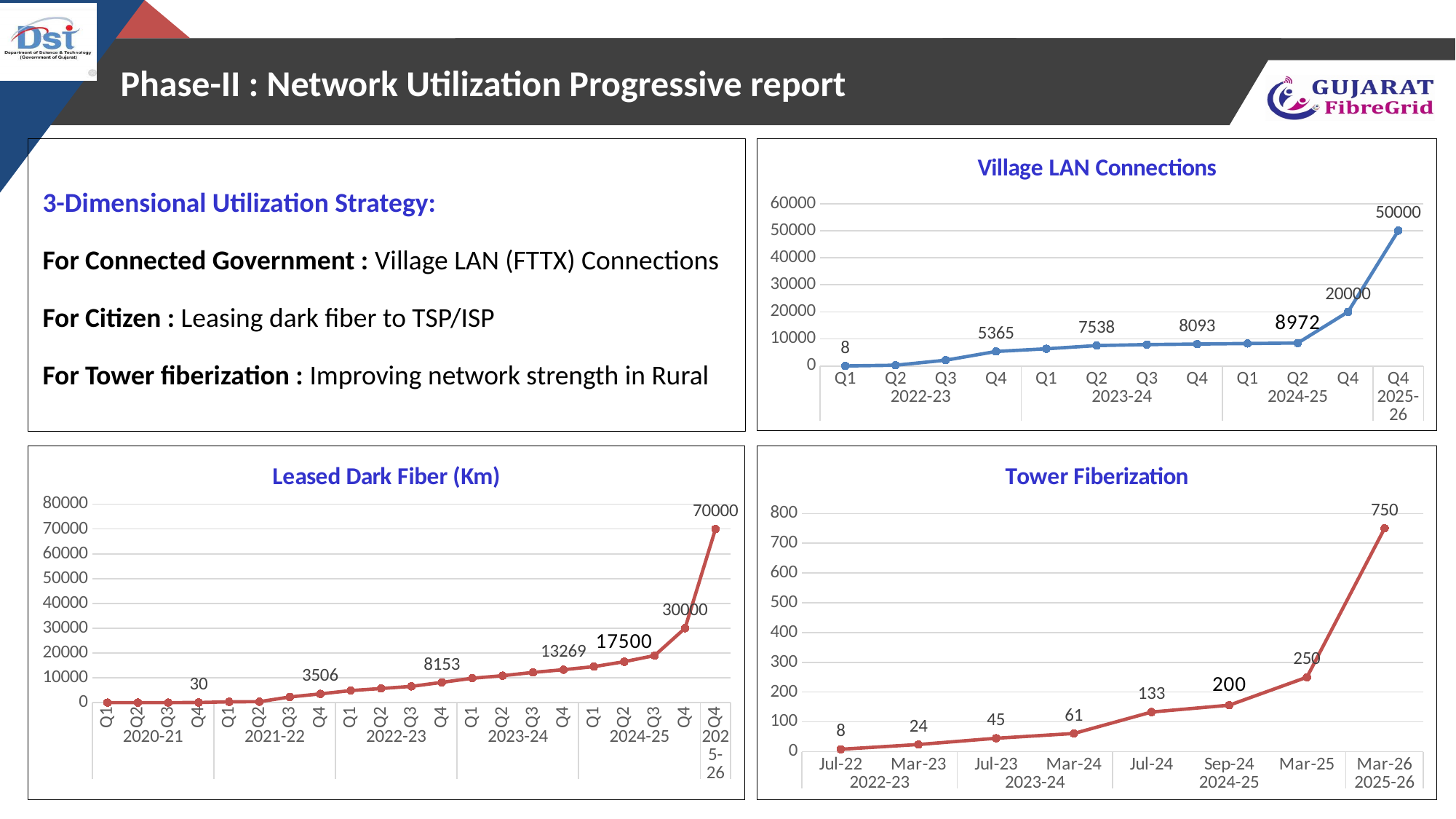
How many data points are plotted in the Tower Fiberization chart? 8 In the Leased Dark Fiber (Km) chart, what is the value for Q4 2023-24? 13269 In the Tower Fiberization chart, what is the value for Mar-26? 750 In the Tower Fiberization chart, which point has the lowest value? Jul-22 In the Village LAN Connections chart, what is the value for Q4 2023-24? 8093 In the Village LAN Connections chart, is the value for Q1 2023-24 greater or less than 10000? less In the Village LAN Connections chart, what is the difference between the Q4 2024-25 value and the Q2 2024-25 value? 11028 In the Tower Fiberization chart, what is the difference between the Mar-25 value and the Sep-24 value? 50 In the Leased Dark Fiber (Km) chart, do the values rise or fall along the x axis? rise In the Leased Dark Fiber (Km) chart, what is the value for Q4 2025-26? 70000 In the Leased Dark Fiber (Km) chart, which is larger: the value for Q4 2024-25 or the value for Q3 2024-25? Q4 2024-25 In the Village LAN Connections chart, what is the value for Q4 2025-26? 50000